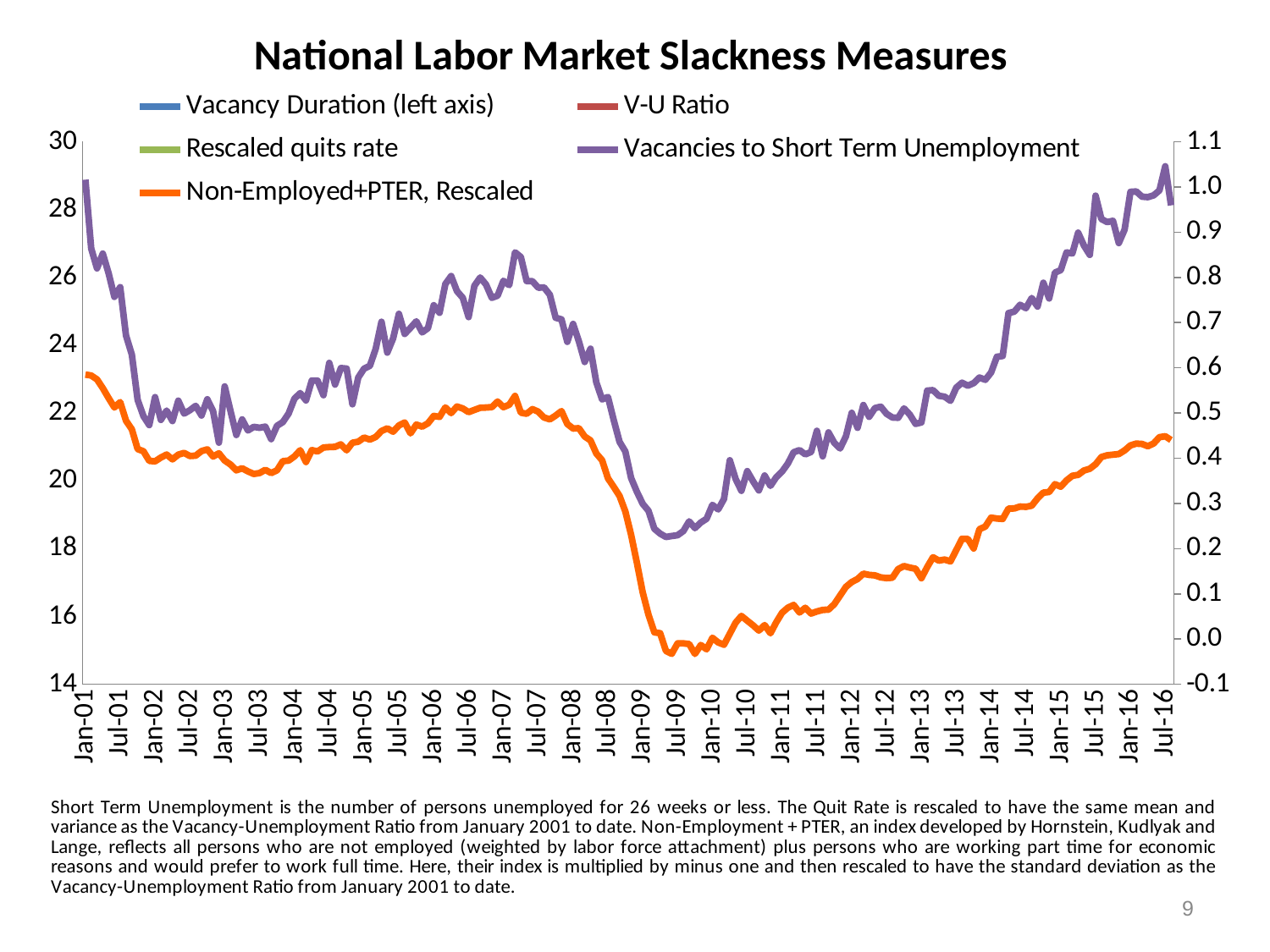
Does the Vacancies to Short Term Unemployment line rise or fall between Jan-08 and Jan-09? fall At Jul-09, which line is plotted higher on the chart: Vacancies to Short Term Unemployment or Non-Employed+PTER, Rescaled? Vacancies to Short Term Unemployment Read against the right-hand axis, is the Vacancies to Short Term Unemployment value at Jan-01 greater or less than 0.9? greater Does the Non-Employed+PTER, Rescaled line rise or fall between Jan-10 and Jul-16? rise What kind of chart is shown on the slide? line chart Read against the right-hand axis, is the Non-Employed+PTER, Rescaled value at Jan-01 greater or less than 0.5? greater What is the title of the chart? National Labor Market Slackness Measures Does the Vacancies to Short Term Unemployment line rise or fall between Jan-13 and Jul-16? rise How many tick labels are shown on the x axis? 32 Read against the right-hand axis, is the Vacancies to Short Term Unemployment value at Jul-09 greater or less than 0.3? less How many series does the legend list? 5 What colour is the Non-Employed+PTER, Rescaled line? orange